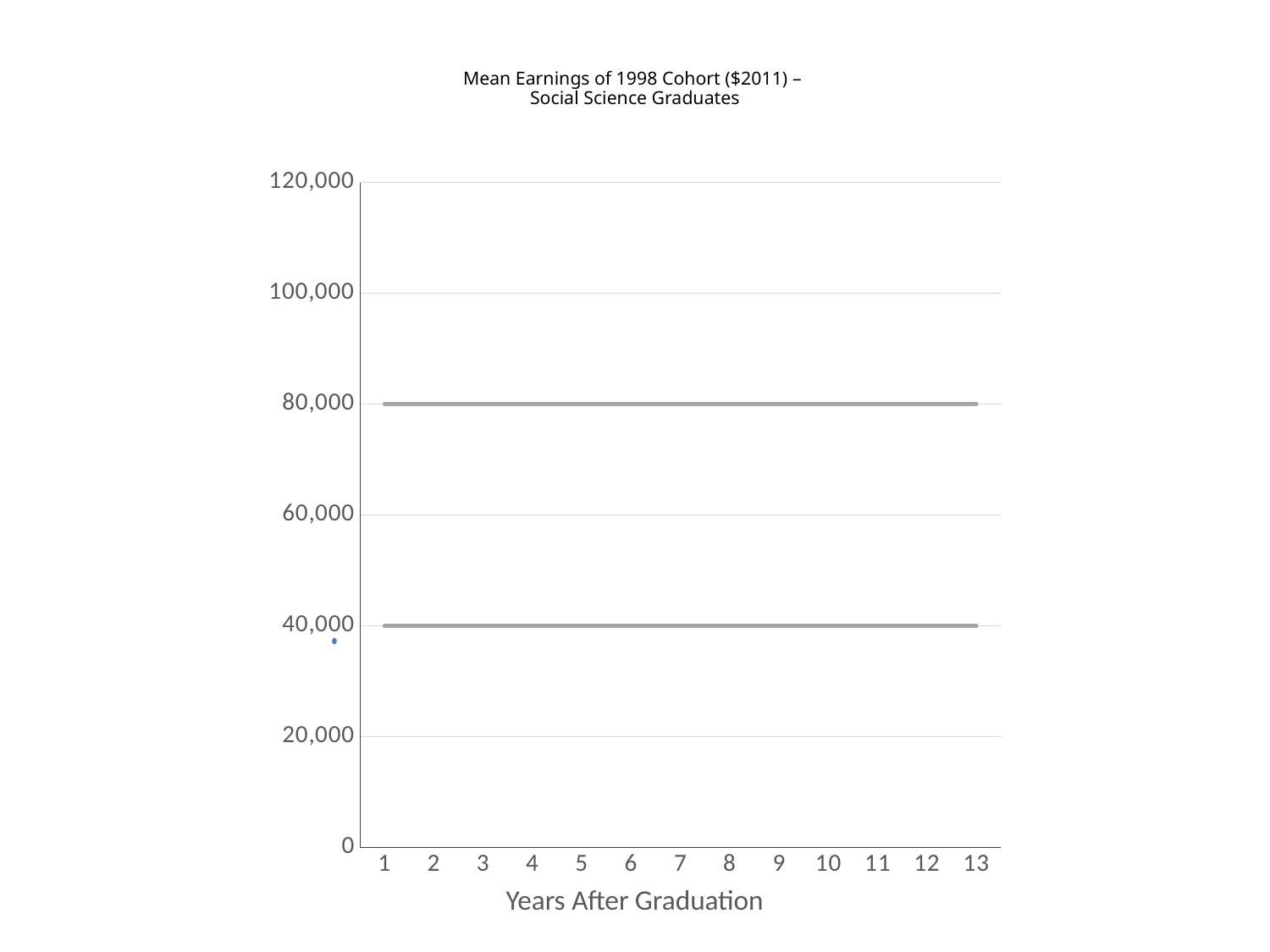
Which gray line is higher, the one at 80,000 or the one at 40,000? the one at 80,000 How many years after graduation are marked along the x axis? 13 Is the value of the blue point near year 1 greater or less than 60,000? less At what value does the upper gray horizontal line sit? 80,000 What is the highest value shown on the y axis? 120,000 What is the difference between the two gray horizontal lines? 40,000 What kind of chart is shown on the slide? line chart Do the gray lines rise, fall, or stay flat from year 1 to year 13? stay flat Is the value of the blue point near year 1 greater or less than 20,000? greater At what value does the lower gray horizontal line sit? 40,000 What is the title of the chart? Mean Earnings of 1998 Cohort ($2011) – Social Science Graduates What is the label of the x axis? Years After Graduation